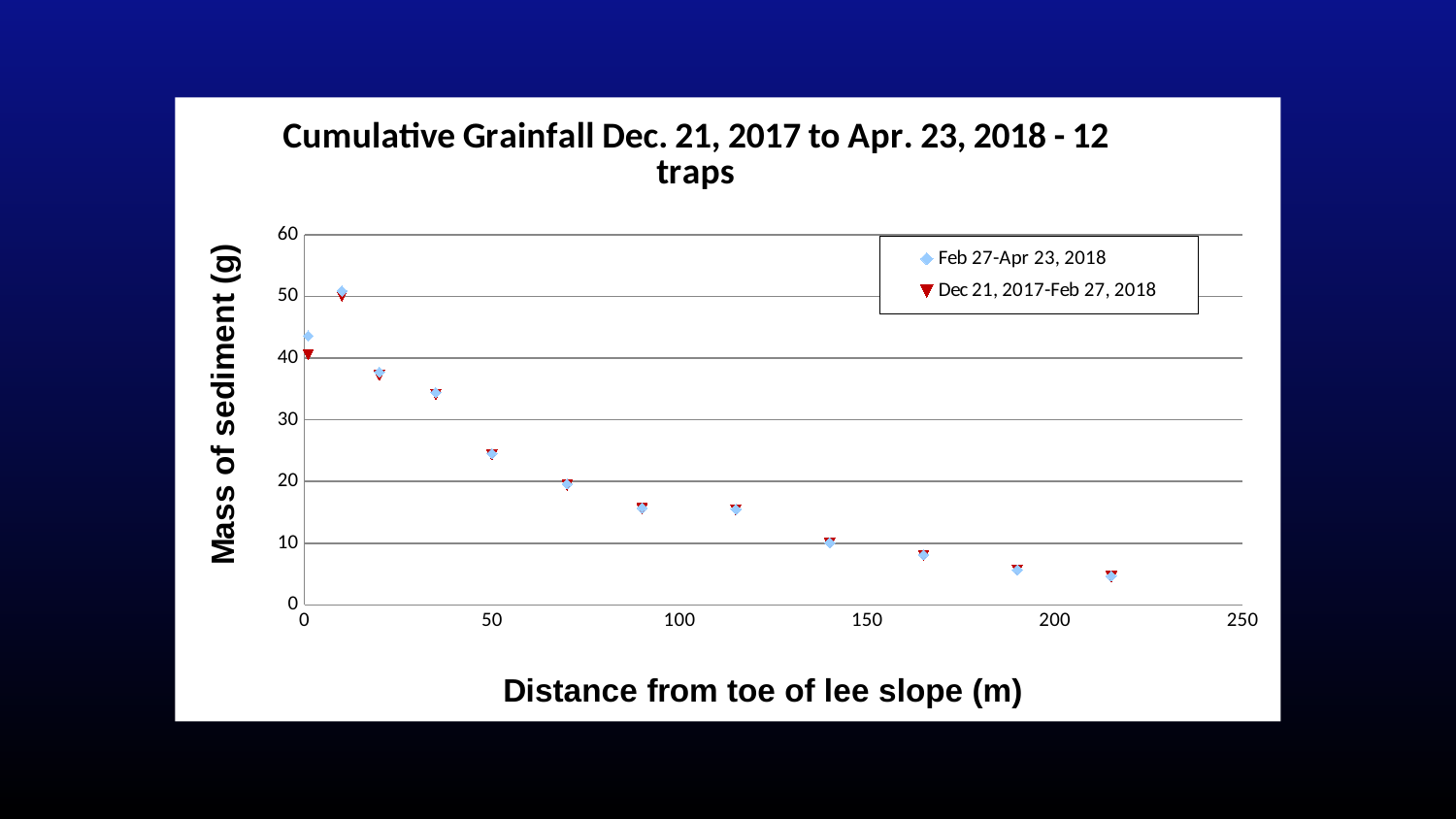
What is the title of the chart? Cumulative Grainfall Dec. 21, 2017 to Apr. 23, 2018 - 12 traps At which distance is the mass of sediment lowest for the Dec 21, 2017-Feb 27, 2018 series? 215 m Which is larger for the Dec 21, 2017-Feb 27, 2018 series: the value at 50 m or the value at 115 m? 50 m How many data points does each series have? 12 At which distance is the mass of sediment highest for the Feb 27-Apr 23, 2018 series? 10 m Is the Feb 27-Apr 23, 2018 value at a distance of 0 m greater or less than 40? greater Is the Feb 27-Apr 23, 2018 value at a distance of 165 m greater or less than 10? less What is the label of the y axis? Mass of sediment (g) What kind of chart is shown on the slide? scatter chart How many series does the legend list? 2 Is the Dec 21, 2017-Feb 27, 2018 value at a distance of 50 m greater or less than 20? greater Do the mass of sediment values rise or fall as distance from the toe of the lee slope increases? fall